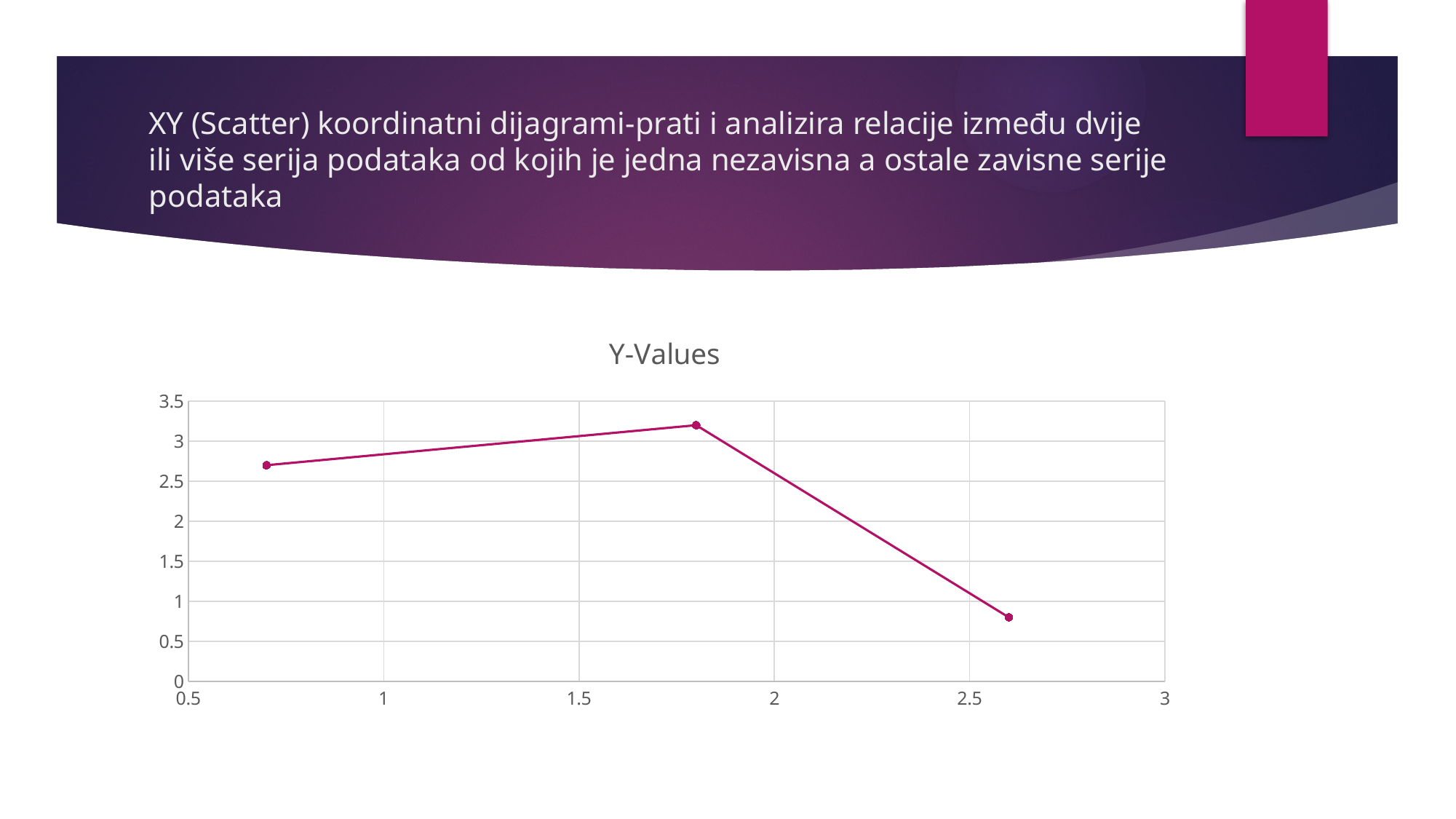
How many data points are plotted on the chart? 3 Which plotted point has the highest y value: the leftmost, the middle, or the rightmost? the middle point What is the highest value shown on the y axis? 3.5 Which plotted point has the lowest y value: the leftmost, the middle, or the rightmost? the rightmost point What kind of chart is shown on the slide? scatter chart What is the title of the chart? Y-Values Is the y value of the leftmost point greater or less than 2.5? greater Does the line rise or fall between the leftmost point and the middle point? rise Does the line rise or fall between the middle point and the rightmost point? fall Is the y value of the middle point greater or less than 3? greater Is the y value of the rightmost point greater or less than 1? less Which has the larger y value, the leftmost point or the rightmost point? the leftmost point